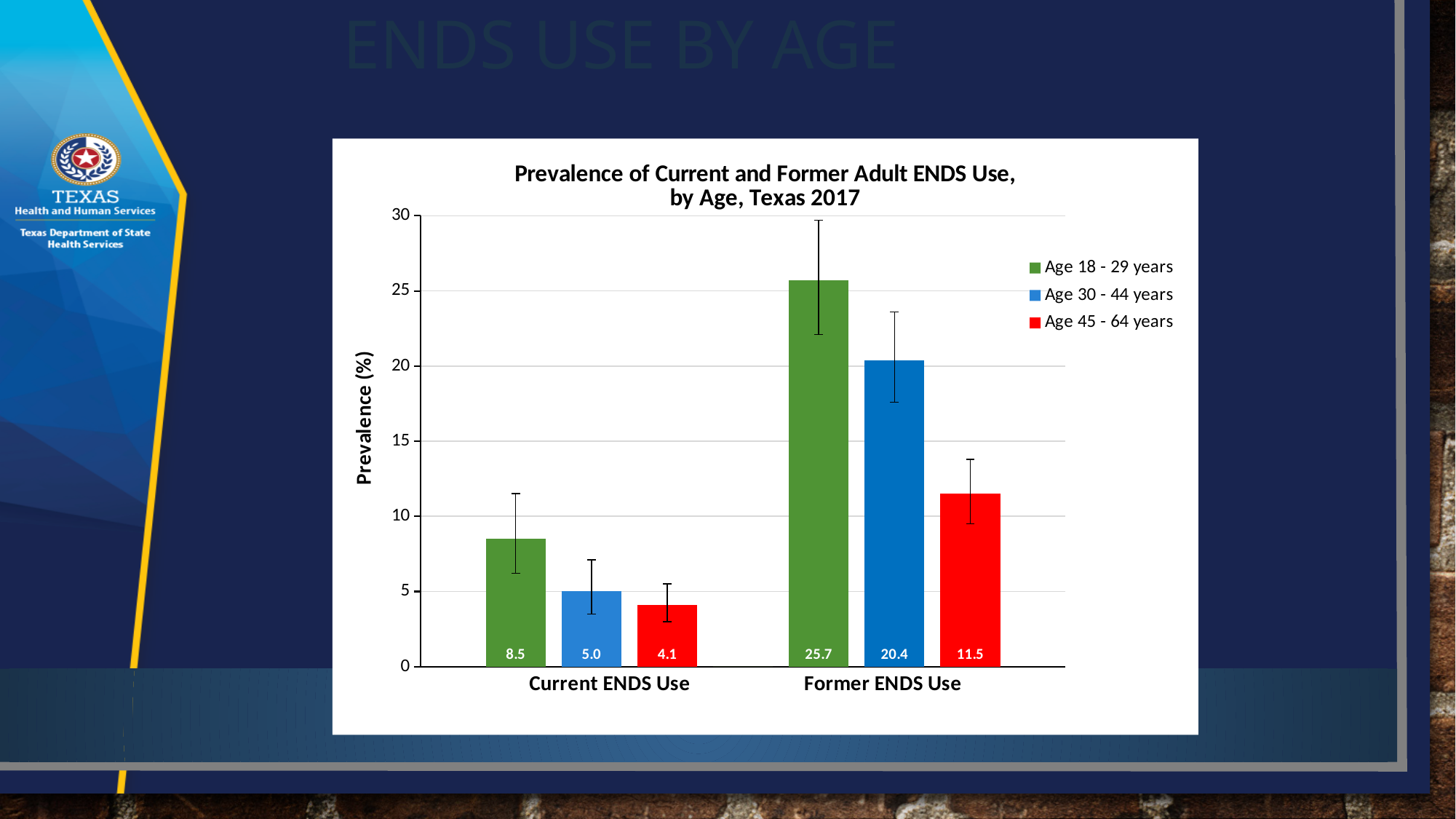
Which is larger: Current ENDS Use for Age 30 - 44 years or Current ENDS Use for Age 45 - 64 years? Age 30 - 44 years What is the label of the y axis? Prevalence (%) How many categories are shown on the x axis? 2 Is the value for Former ENDS Use for Age 18 - 29 years greater or less than 25? greater What is the prevalence of Former ENDS Use for Age 30 - 44 years? 20.4 What kind of chart is shown on the slide? Bar chart What is the prevalence of Former ENDS Use for Age 45 - 64 years? 11.5 Which age group has the lowest prevalence of Current ENDS Use? Age 45 - 64 years How many series does the legend list? 3 Which age group has the highest prevalence of Former ENDS Use? Age 18 - 29 years What is the difference between Former ENDS Use and Current ENDS Use for Age 18 - 29 years? 17.2 What is the prevalence of Current ENDS Use for Age 18 - 29 years? 8.5